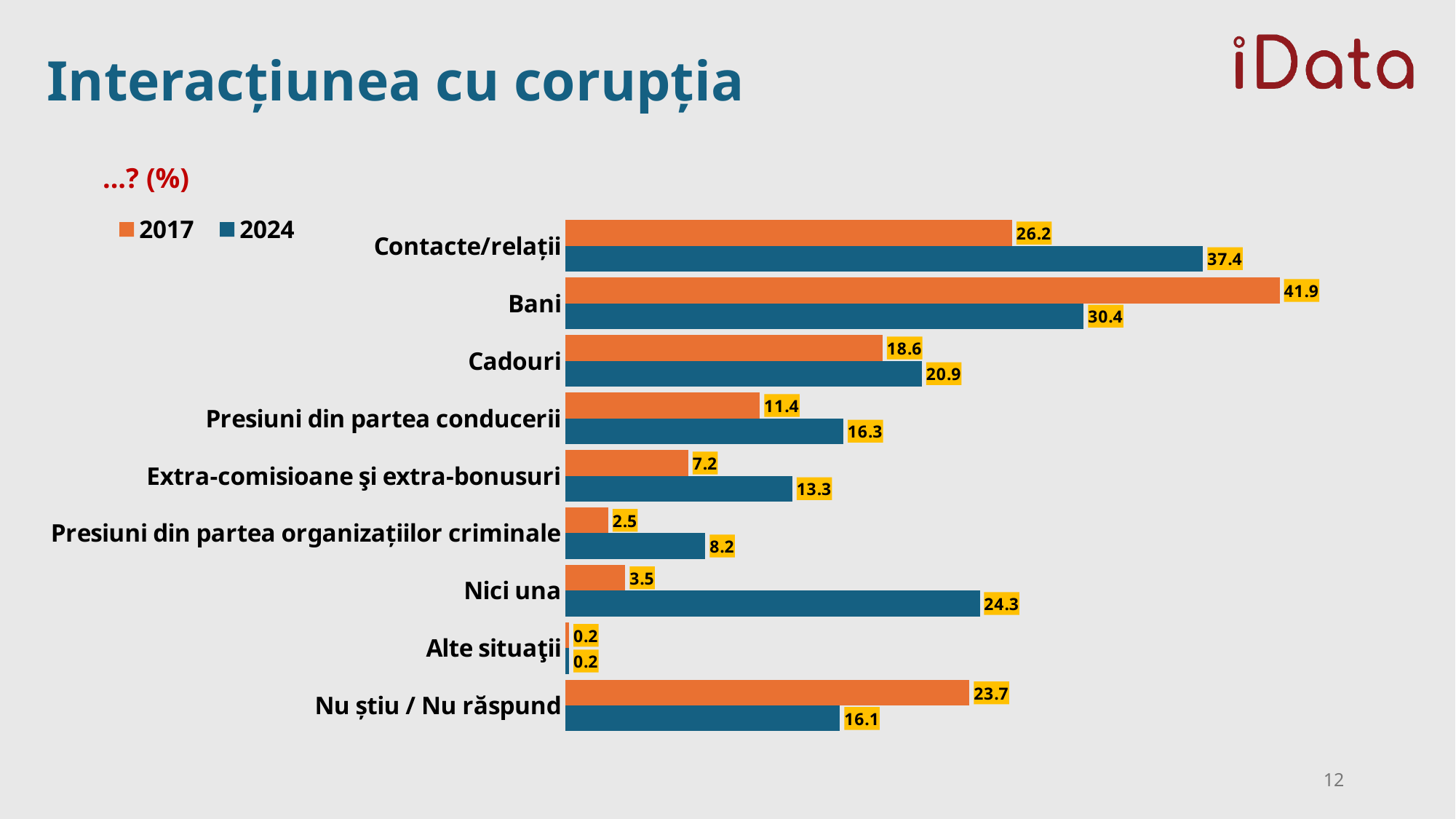
Which is larger for Cadouri, the 2017 value or the 2024 value? 2024 How many series does the legend list? 2 What is the difference between the 2024 and 2017 values for Nici una? 20.8 What is the 2017 value for Bani? 41.9 What kind of chart is shown on the slide? bar chart Which category has the lowest 2024 value? Alte situaţii What is the 2024 value for Nici una? 24.3 How many categories are shown on the chart? 9 Which series is shown in orange? 2017 What is the difference between the 2017 and 2024 values for Bani? 11.5 What is the 2024 value for Contacte/relații? 37.4 Which category has the highest 2017 value? Bani